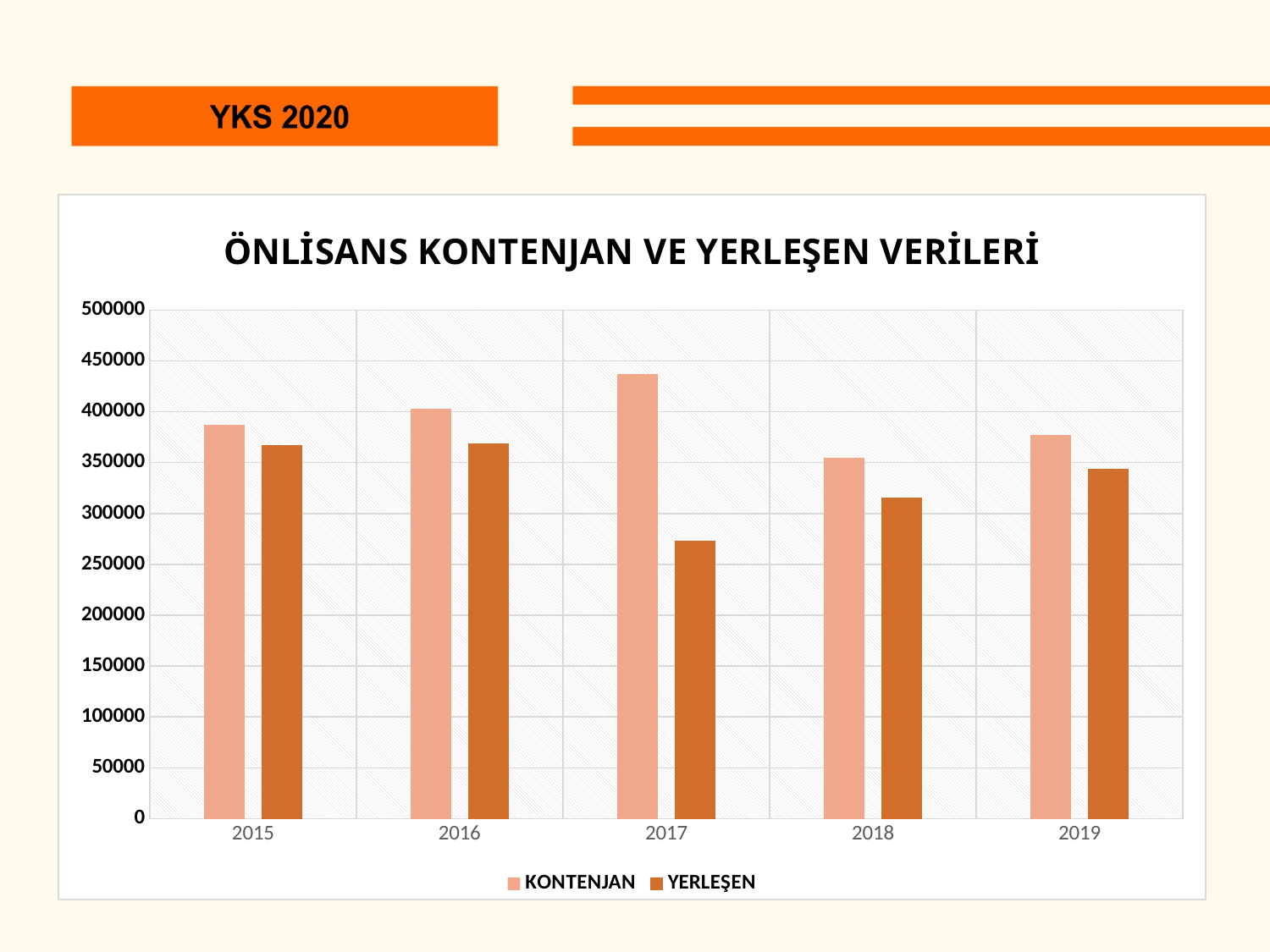
Is the KONTENJAN value for 2017 greater or less than 400000? greater In which year is the KONTENJAN value highest? 2017 How many years are shown on the x axis? 5 Is the YERLEŞEN value for 2017 greater or less than 300000? less What is the title of the chart? ÖNLİSANS KONTENJAN VE YERLEŞEN VERİLERİ Which is larger in 2017, KONTENJAN or YERLEŞEN? KONTENJAN What type of chart is shown on the slide? bar chart In which year is the KONTENJAN value lowest? 2018 Which year has the larger YERLEŞEN value, 2018 or 2019? 2019 How many series does the legend list? 2 Is the YERLEŞEN value for 2018 greater or less than 300000? greater In which year is the YERLEŞEN value lowest? 2017